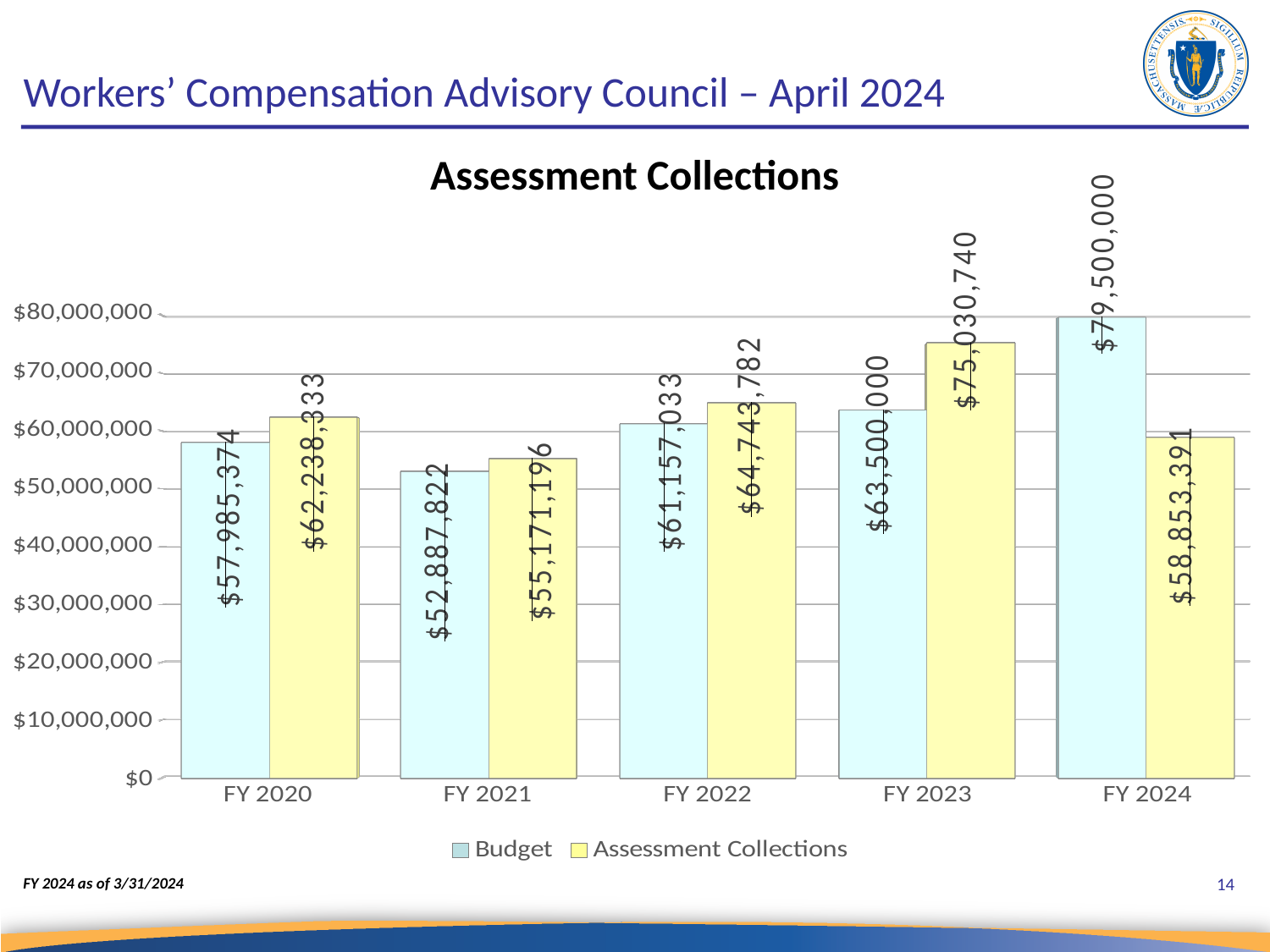
Which fiscal year has the lowest Assessment Collections value? FY 2021 How many series does the legend list? 2 What is the difference between Assessment Collections and Budget for FY 2023? $11,530,740 What type of chart is shown on the slide? Bar chart How many fiscal years are shown on the x axis? 5 What is the difference between the Budget and Assessment Collections values for FY 2024? $20,646,609 What is the Budget value for FY 2021? $52,887,822 What is the Budget value for FY 2024? $79,500,000 What is the Assessment Collections value for FY 2020? $62,238,333 What is the Assessment Collections value for FY 2023? $75,030,740 Which fiscal year has the highest Budget value? FY 2024 For FY 2022, which is larger: Budget or Assessment Collections? Assessment Collections